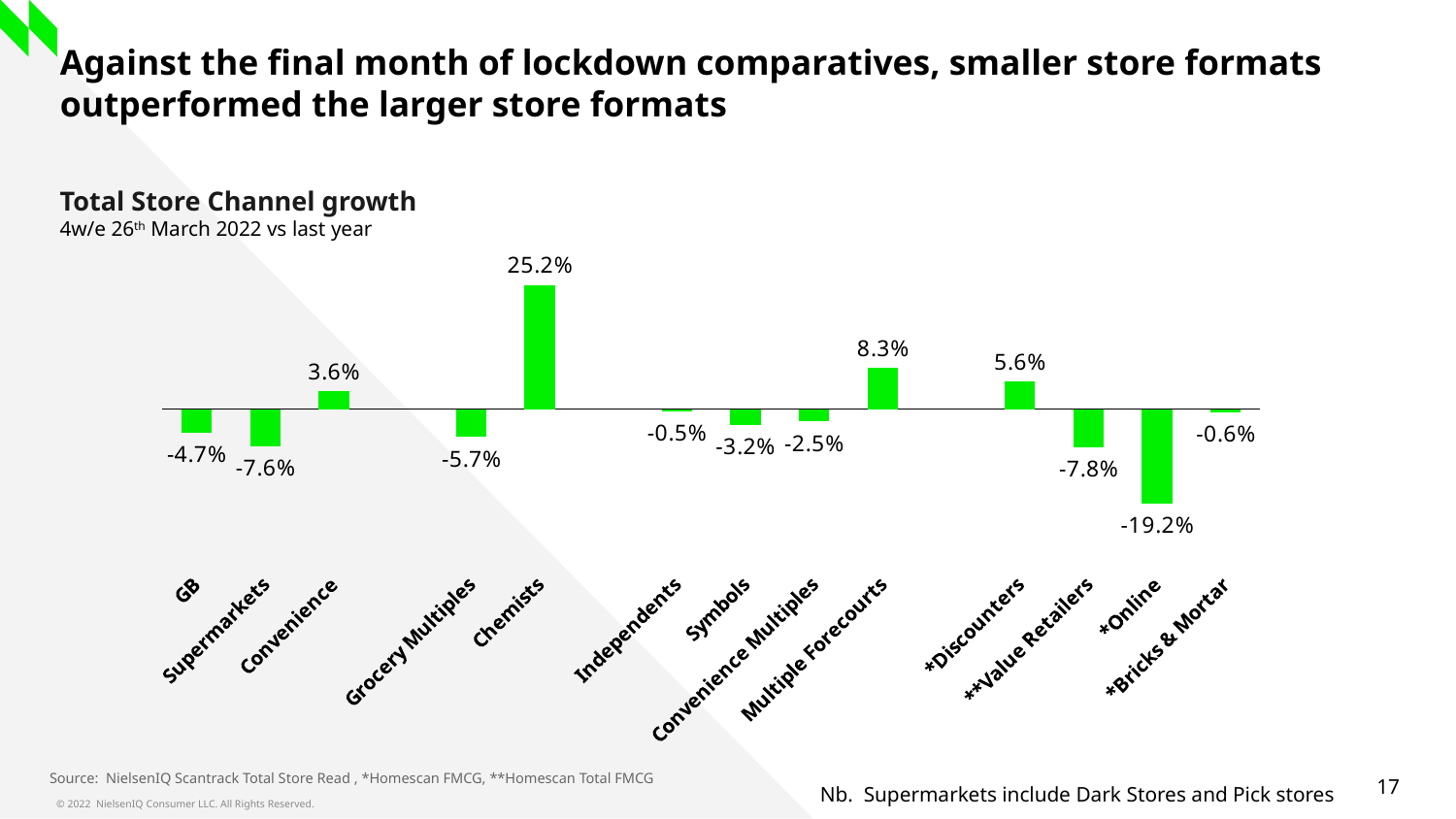
What is the difference between the growth values for Chemists and Multiple Forecourts? 16.9 percentage points What is the growth value for Multiple Forecourts? 8.3% What kind of chart is shown on the slide? Bar chart What is the title of the chart? Total Store Channel growth What is the growth value for Independents? -0.5% How many channels are shown in the chart? 13 What is the growth value for Chemists? 25.2% What is the growth value for *Online? -19.2% What is the growth value for Supermarkets? -7.6% Which channel has the lowest growth value? *Online Which has the higher growth value, Convenience or *Discounters? *Discounters Which channel has the highest growth value? Chemists